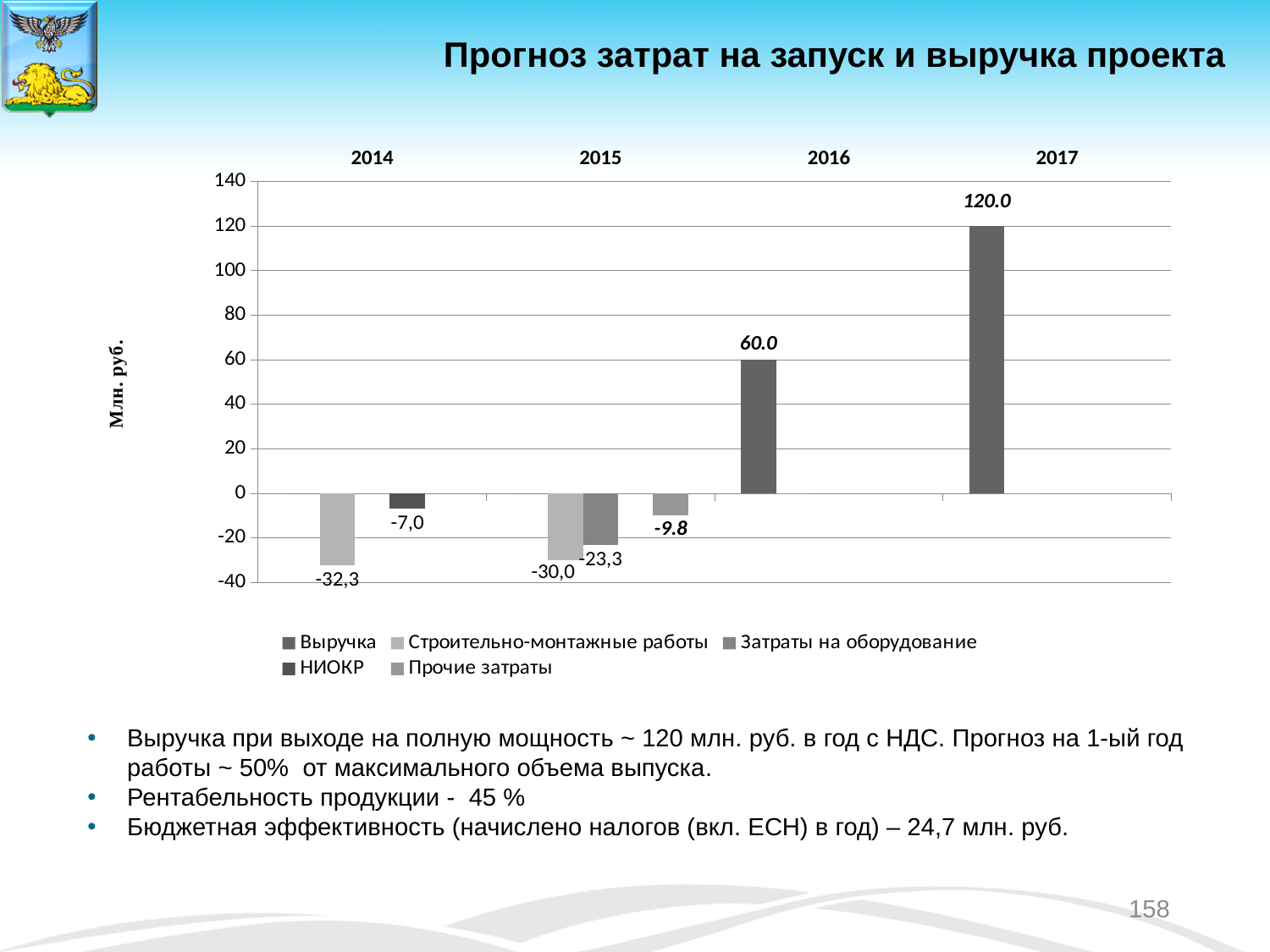
In which year is the highest value on the chart plotted? 2017 What is the label of the vertical axis? Млн. руб. By how much does Выручка in 2017 exceed Выручка in 2016? 60.0 What is the value of Прочие затраты in 2015? -9.8 What is the value of Строительно-монтажные работы in 2014? -32,3 How many series does the legend list? 5 What kind of chart is shown on the slide? bar chart Which is larger, Выручка in 2016 or Выручка in 2017? 2017 What is the value of Строительно-монтажные работы in 2015? -30,0 What is the value of Выручка in 2017? 120.0 How many years are shown along the x axis? 4 What is the value of Выручка in 2016? 60.0